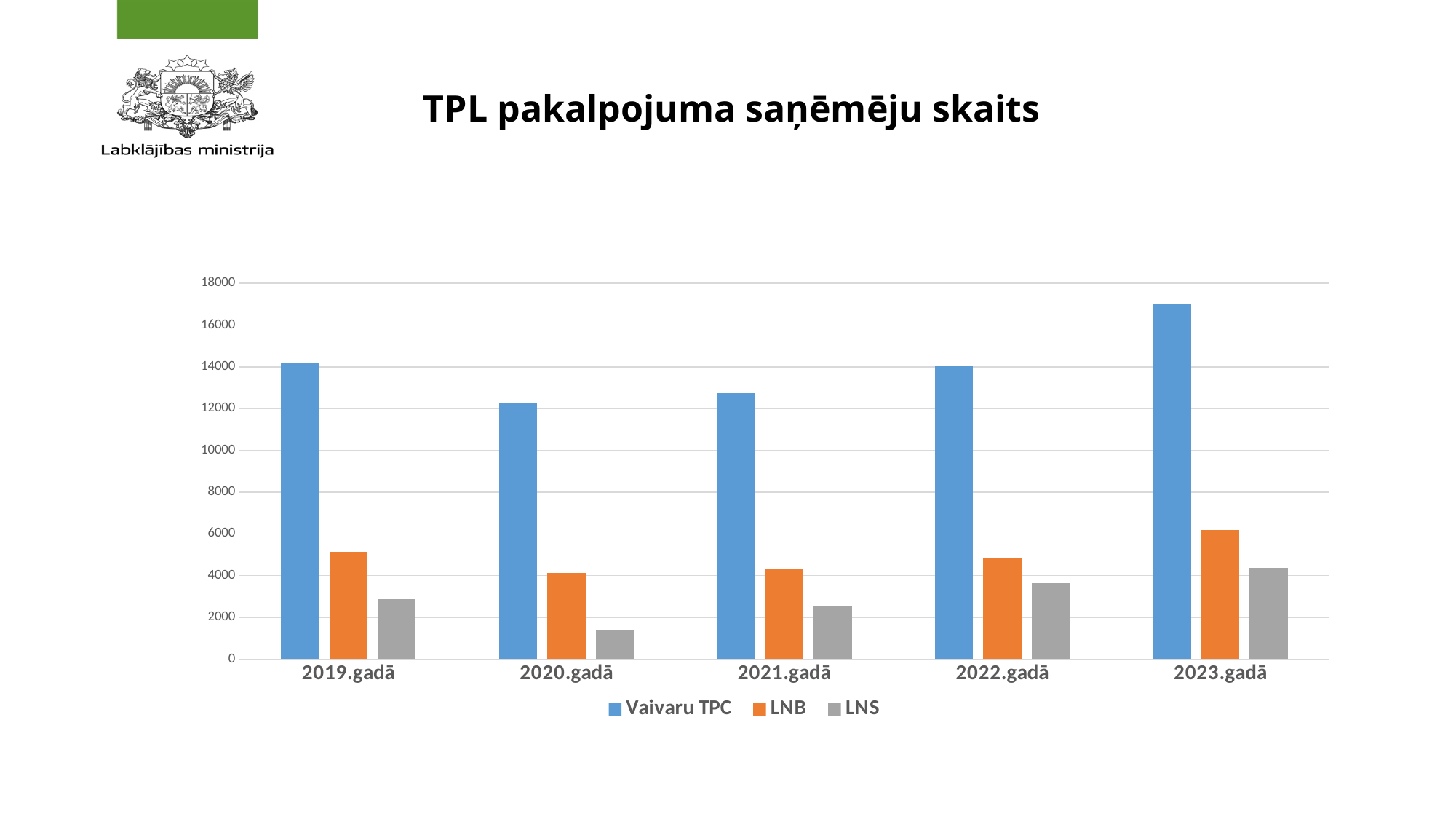
In which year is the value for Vaivaru TPC lowest? 2020.gadā How many series does the legend list? 3 How many years are shown on the x axis? 5 In which year is the value for LNS lowest? 2020.gadā Which is larger: the value for LNB in 2019.gadā or in 2020.gadā? 2019.gadā What kind of chart is shown on the slide? bar chart In which year is the value for LNS highest? 2023.gadā Do the values for LNS rise or fall from 2020.gadā to 2023.gadā? rise In which year is the value for Vaivaru TPC highest? 2023.gadā Is the value for LNS in 2020.gadā greater or less than 2000? less What is the title of the chart? TPL pakalpojuma saņēmēju skaits Is the value for Vaivaru TPC in 2023.gadā greater or less than 16000? greater